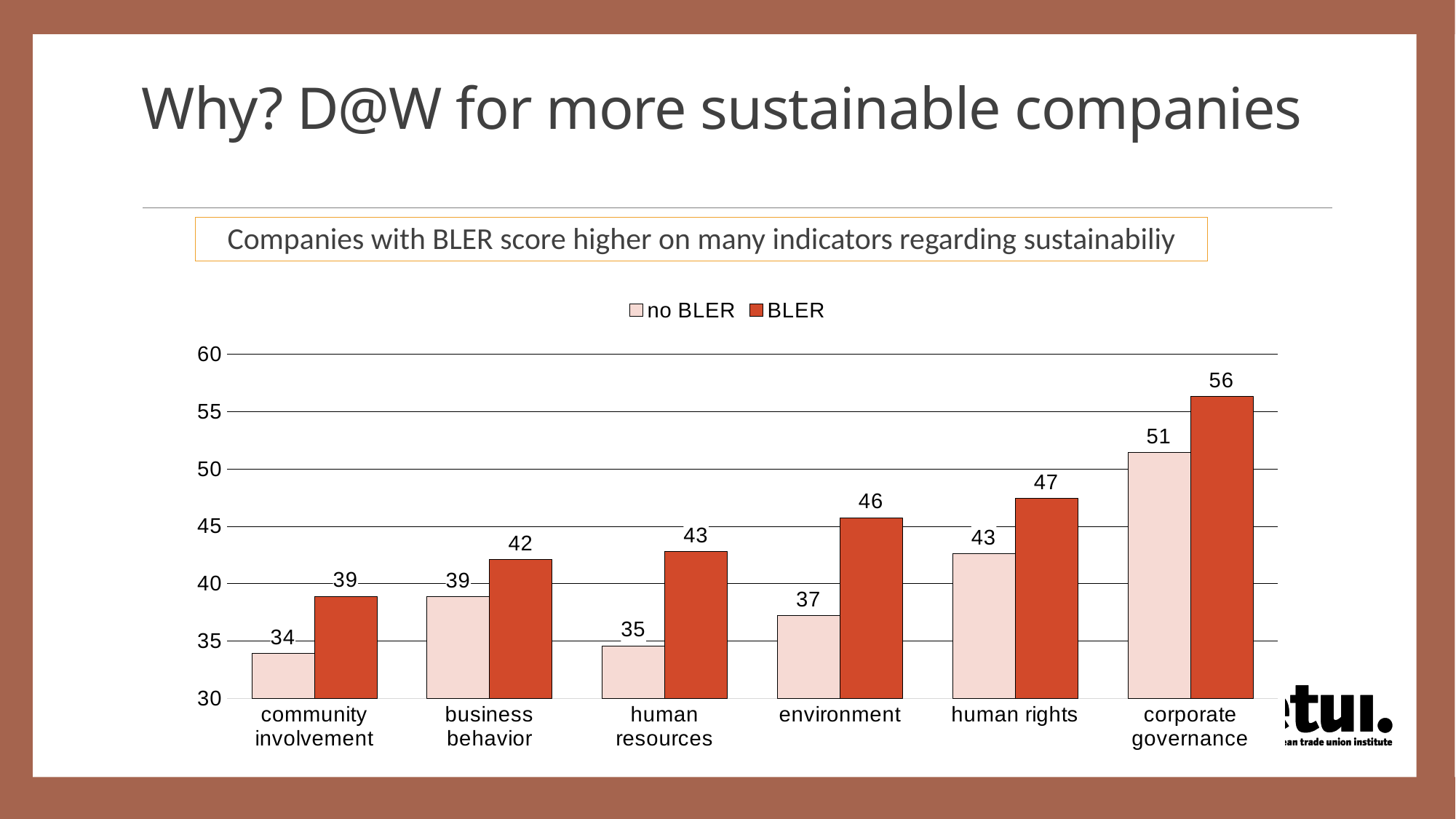
Which is larger for human rights: the BLER value or the no BLER value? BLER What is the BLER value for corporate governance? 56 What kind of chart is shown on the slide? bar chart How many categories are shown on the x axis? 6 What is the no BLER value for community involvement? 34 What is the BLER value for environment? 46 How many series does the legend list? 2 Which category has the highest BLER value? corporate governance What is the no BLER value for human resources? 35 Which category has the lowest no BLER value? community involvement Is the no BLER value for corporate governance greater or less than 50? greater What is the difference between the BLER and no BLER values for human resources? 8